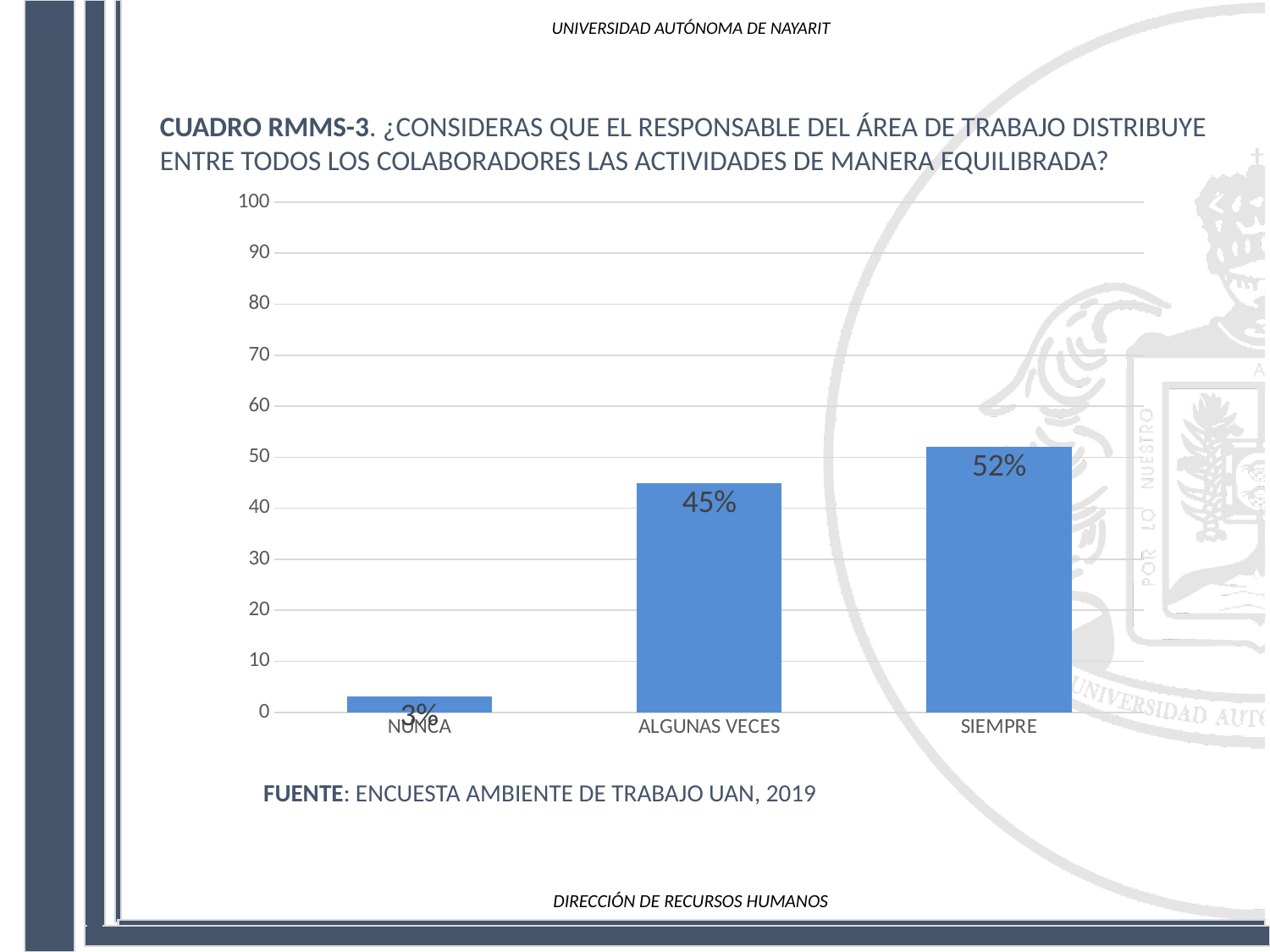
Is the value for SIEMPRE greater or less than 50? greater How many categories are shown on the x axis? 3 What is the value for NUNCA? 3% What kind of chart is shown on the slide? bar chart What is the value for SIEMPRE? 52% Which category has the lowest value? NUNCA What is the value for ALGUNAS VECES? 45% Which is larger, the value for ALGUNAS VECES or the value for SIEMPRE? SIEMPRE What is the difference between the values for ALGUNAS VECES and NUNCA? 42% What source is cited below the chart? ENCUESTA AMBIENTE DE TRABAJO UAN, 2019 What is the difference between the values for SIEMPRE and ALGUNAS VECES? 7% Which category has the highest value? SIEMPRE